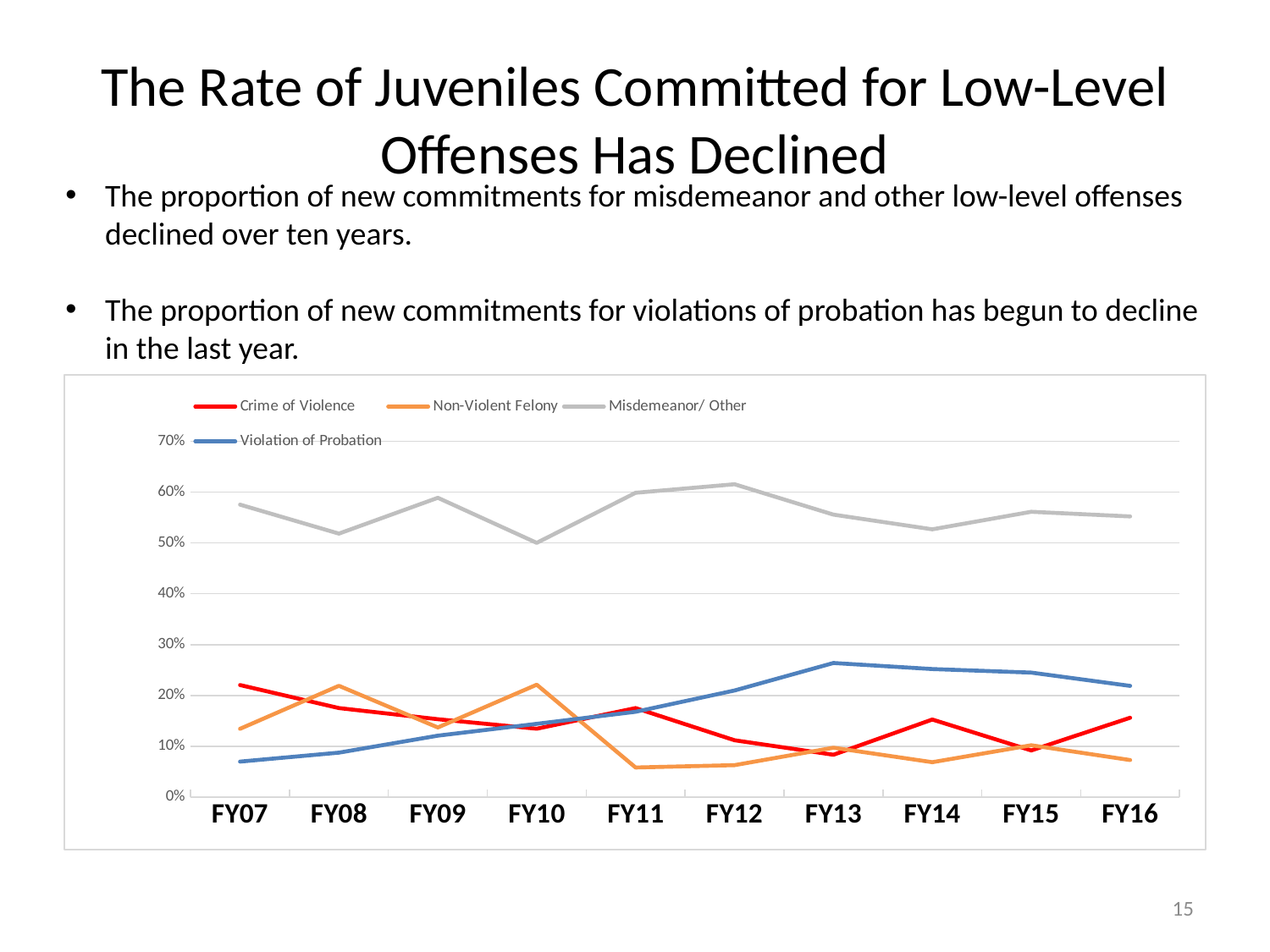
Which series has the highest value in FY16? Misdemeanor/ Other How many series does the chart's legend list? 4 Does the Violation of Probation series rise or fall from FY07 to FY13? rise What kind of chart is shown on the slide? line chart Is the value for Misdemeanor/ Other in FY07 greater or less than 50%? greater In which fiscal year is the Violation of Probation series at its lowest? FY07 Is the value for Misdemeanor/ Other in FY10 greater or less than 60%? less Is the value for Violation of Probation in FY07 greater or less than 10%? less In FY16, which is larger: Violation of Probation or Crime of Violence? Violation of Probation How many fiscal years are plotted along the x axis? 10 Which series is drawn in red in the chart? Crime of Violence